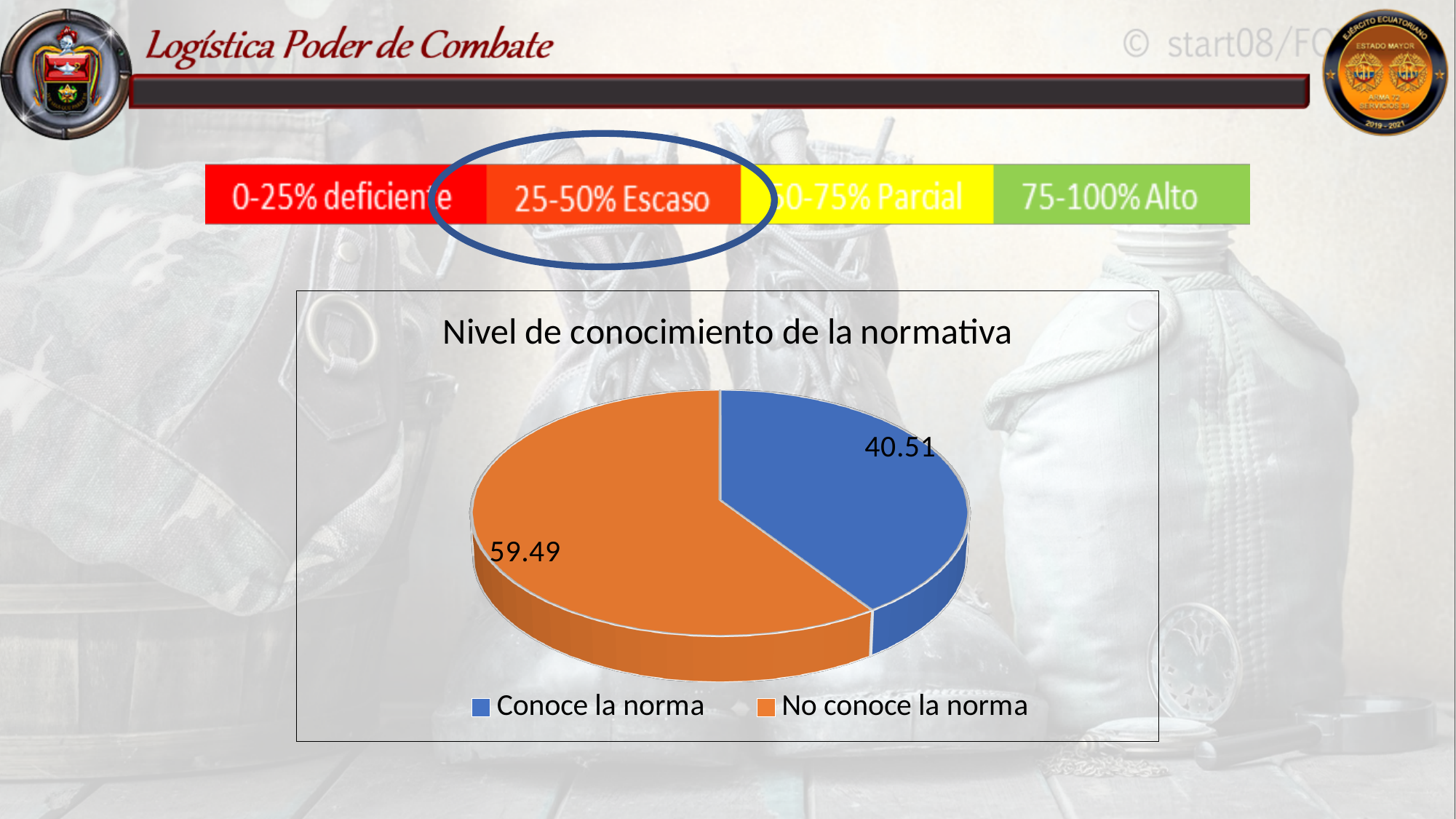
What is the value for "Conoce la norma"? 40.51 What kind of chart is shown on the slide? Pie chart Which is larger, the value for "Conoce la norma" or for "No conoce la norma"? No conoce la norma Which category has the largest slice of the pie? No conoce la norma How many slices does the pie chart have? 2 What is the title of the chart? Nivel de conocimiento de la normativa What is the difference between the values for "No conoce la norma" and "Conoce la norma"? 18.98 What is the value for "No conoce la norma"? 59.49 Which category has the smallest slice of the pie? Conoce la norma What colour is the slice for "Conoce la norma"? Blue What is the total of the two slice values? 100